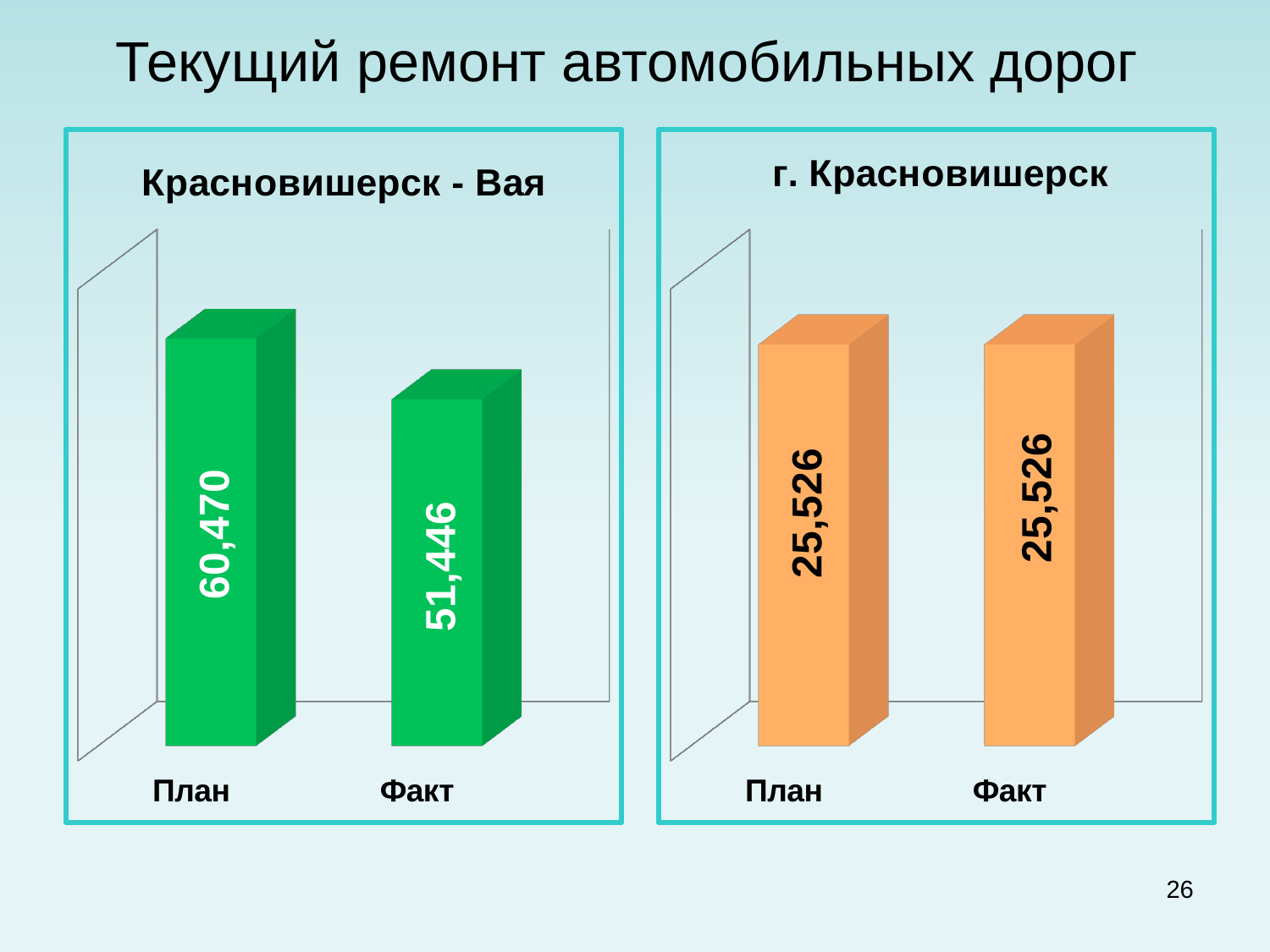
In the chart titled "г. Красновишерск", are the values for План and Факт equal or different? equal In the chart titled "Красновишерск - Вая", what is the difference between the План and Факт values? 9,024 How many categories are shown in the chart titled "г. Красновишерск"? 2 In the chart titled "Красновишерск - Вая", what is the value for План? 60,470 What colour are the bars in the chart titled "г. Красновишерск"? orange In the chart titled "г. Красновишерск", what is the value for План? 25,526 In the chart titled "Красновишерск - Вая", which category has the lower value? Факт In the chart titled "Красновишерск - Вая", is the value for План larger or smaller than the value for Факт? larger In the chart titled "Красновишерск - Вая", what is the value for Факт? 51,446 In the chart titled "Красновишерск - Вая", which category has the higher value? План What type of chart is the left chart, titled "Красновишерск - Вая"? bar chart In the chart titled "г. Красновишерск", what is the value for Факт? 25,526